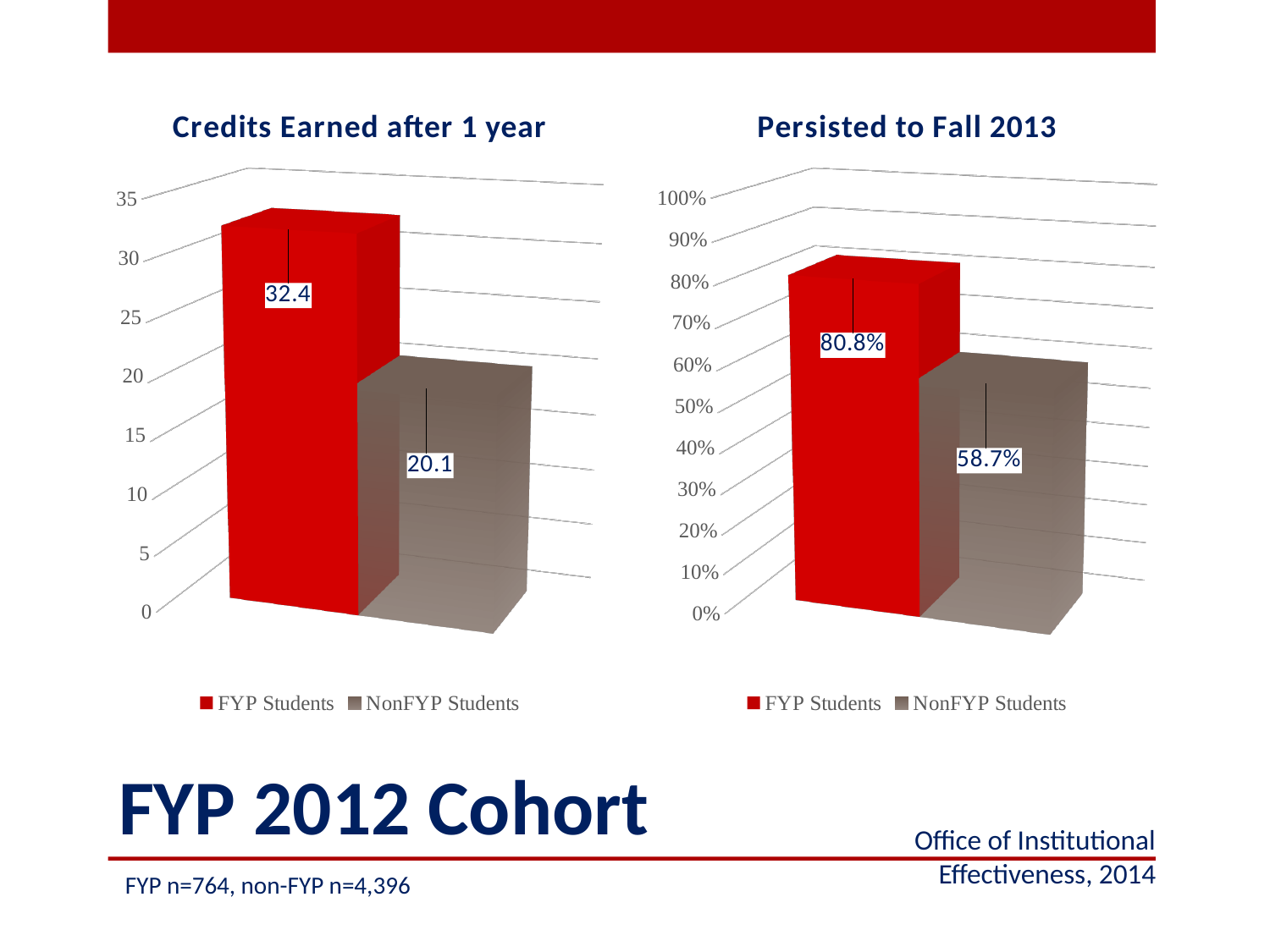
How many series does the legend of the 'Credits Earned after 1 year' chart list? 2 What kind of chart is the 'Persisted to Fall 2013' chart? Bar chart In the 'Credits Earned after 1 year' chart, what is the value for NonFYP Students? 20.1 In the 'Persisted to Fall 2013' chart, what is the value for NonFYP Students? 58.7% In the 'Persisted to Fall 2013' chart, is the value for NonFYP Students greater or less than 50%? greater In the 'Credits Earned after 1 year' chart, which series has the lowest value? NonFYP Students In the 'Credits Earned after 1 year' chart, what is the value for FYP Students? 32.4 In the 'Persisted to Fall 2013' chart, which series has the higher value? FYP Students What colour are the FYP Students bars in both charts? Red In the 'Persisted to Fall 2013' chart, what is the value for FYP Students? 80.8% In the 'Credits Earned after 1 year' chart, what is the difference between the FYP Students and NonFYP Students values? 12.3 In the 'Persisted to Fall 2013' chart, what is the difference between the FYP Students and NonFYP Students values? 22.1%